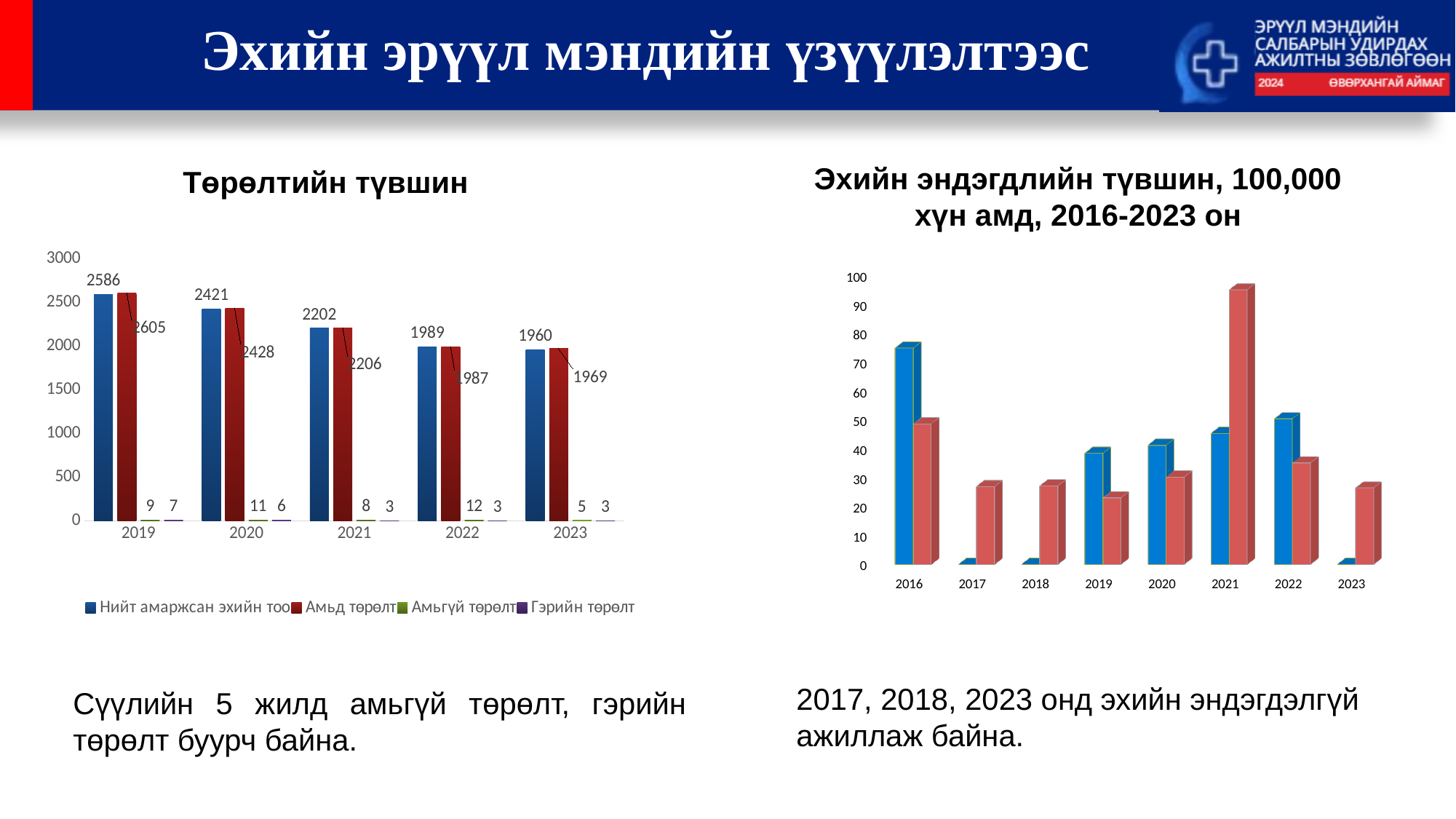
On the chart titled 'Төрөлтийн түвшин', what is the value of 'Амьгүй төрөлт' for 2022? 12 On the chart titled 'Төрөлтийн түвшин', what is the value of 'Нийт амаржсан эхийн тоо' for 2019? 2586 On the chart titled 'Төрөлтийн түвшин', does the 'Нийт амаржсан эхийн тоо' series rise or fall from 2019 to 2023? fall On the chart titled 'Төрөлтийн түвшин', which year has the lowest value for 'Амьгүй төрөлт'? 2023 On the chart titled 'Төрөлтийн түвшин', what is the difference between the 'Нийт амаржсан эхийн тоо' values for 2019 and 2023? 626 On the chart titled 'Эхийн эндэгдлийн түвшин, 100,000 хүн амд, 2016-2023 он', is the value of the blue bar for 2016 greater or less than 70? greater What kind of chart is the chart titled 'Эхийн эндэгдлийн түвшин, 100,000 хүн амд, 2016-2023 он'? bar chart On the chart titled 'Төрөлтийн түвшин', what is the value of 'Амьд төрөлт' for 2023? 1969 On the chart titled 'Эхийн эндэгдлийн түвшин, 100,000 хүн амд, 2016-2023 он', is the value of the red bar for 2021 greater or less than 90? greater On the chart titled 'Эхийн эндэгдлийн түвшин, 100,000 хүн амд, 2016-2023 он', how many years are shown on the x axis? 8 On the chart titled 'Төрөлтийн түвшин', which year has the highest value for 'Нийт амаржсан эхийн тоо'? 2019 On the chart titled 'Төрөлтийн түвшин', how many series does the legend list? 4